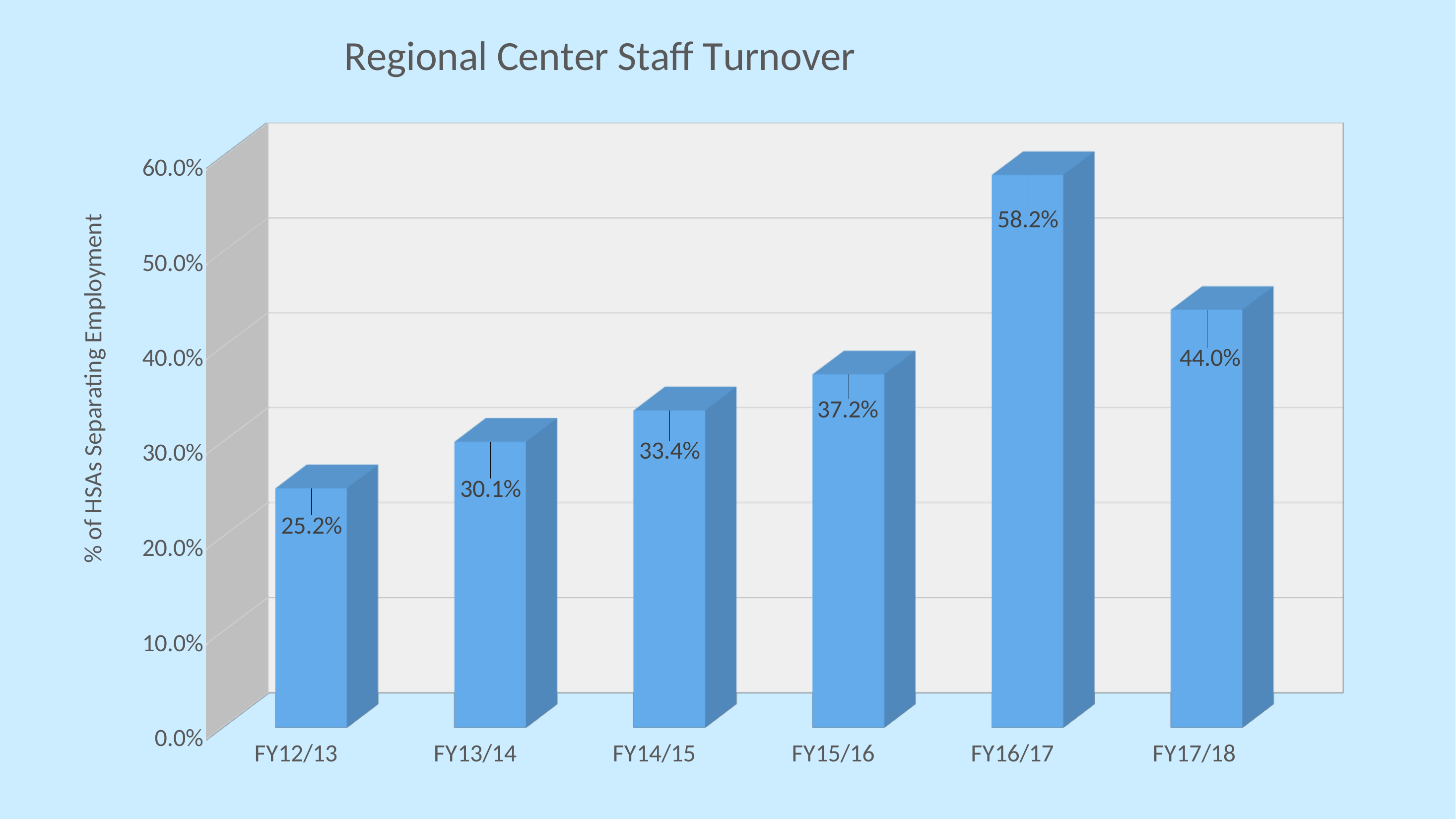
What is the staff turnover value for FY17/18? 44.0% What is the difference in turnover between FY15/16 and FY14/15? 3.8% What is the title of the chart? Regional Center Staff Turnover Does staff turnover rise or fall from FY12/13 to FY16/17? Rise How many fiscal years are shown on the chart? 6 Which has a higher turnover value, FY13/14 or FY15/16? FY15/16 What is the difference in turnover between FY16/17 and FY17/18? 14.2% What is the staff turnover value for FY16/17? 58.2% What is the staff turnover value for FY12/13? 25.2% Which fiscal year has the highest staff turnover? FY16/17 Which fiscal year has the lowest staff turnover? FY12/13 What kind of chart is shown on the slide? Bar chart